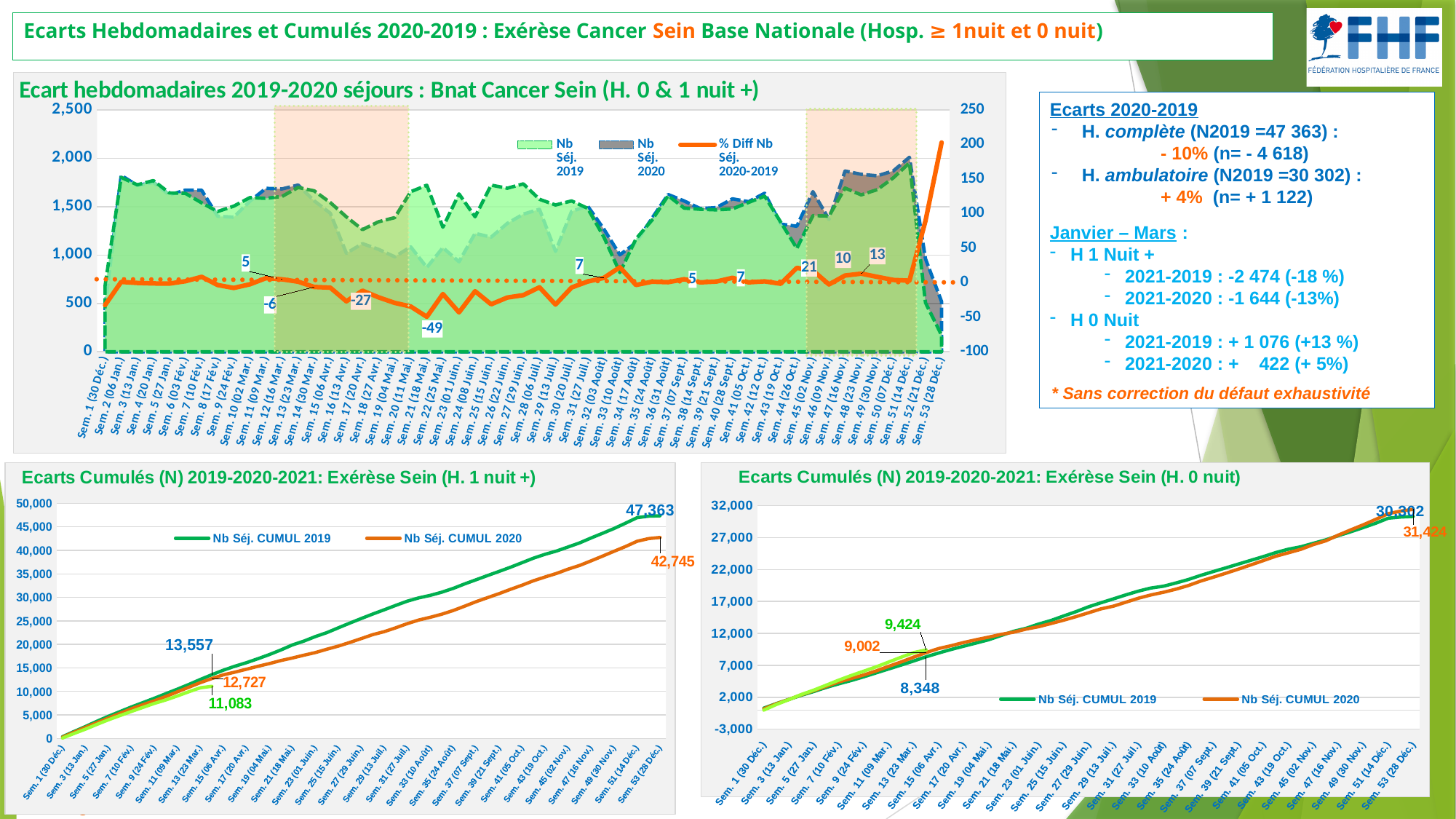
In the bottom-left chart (Ecarts Cumulés, H. 1 nuit +), what value is labelled in blue for Nb Séj. CUMUL 2019 around Sem. 13-15? 13,557 In the bottom-left chart (Ecarts Cumulés, H. 1 nuit +), do the cumulative values rise or fall along the x axis? Rise In the bottom-left chart (Ecarts Cumulés, H. 1 nuit +), what is the final cumulative value labelled for Nb Séj. CUMUL 2019? 47,363 What kind of chart is the bottom-left chart (Ecarts Cumulés, H. 1 nuit +)? Line chart In the bottom-right chart (Ecarts Cumulés, H. 0 nuit), which series ends higher at the last week: Nb Séj. CUMUL 2019 or Nb Séj. CUMUL 2020? Nb Séj. CUMUL 2020 In the top chart (Ecart hebdomadaires 2019-2020), what is the lowest labelled value on the % Diff Nb Séj. 2020-2019 line? -49 How many series does the legend of the top chart (Ecart hebdomadaires 2019-2020) list? 3 In the bottom-right chart (Ecarts Cumulés, H. 0 nuit), what is the difference between the final 2020 value (31,424) and the final 2019 value (30,302)? 1,122 In the bottom-left chart (Ecarts Cumulés, H. 1 nuit +), what is the final cumulative value labelled for Nb Séj. CUMUL 2020? 42,745 In the bottom-left chart (Ecarts Cumulés, H. 1 nuit +), what is the difference between the final 2019 value (47,363) and the final 2020 value (42,745)? 4,618 In the bottom-right chart (Ecarts Cumulés, H. 0 nuit), what is the final cumulative value labelled for Nb Séj. CUMUL 2020? 31,424 In the bottom-right chart (Ecarts Cumulés, H. 0 nuit), what is the final cumulative value labelled for Nb Séj. CUMUL 2019? 30,302